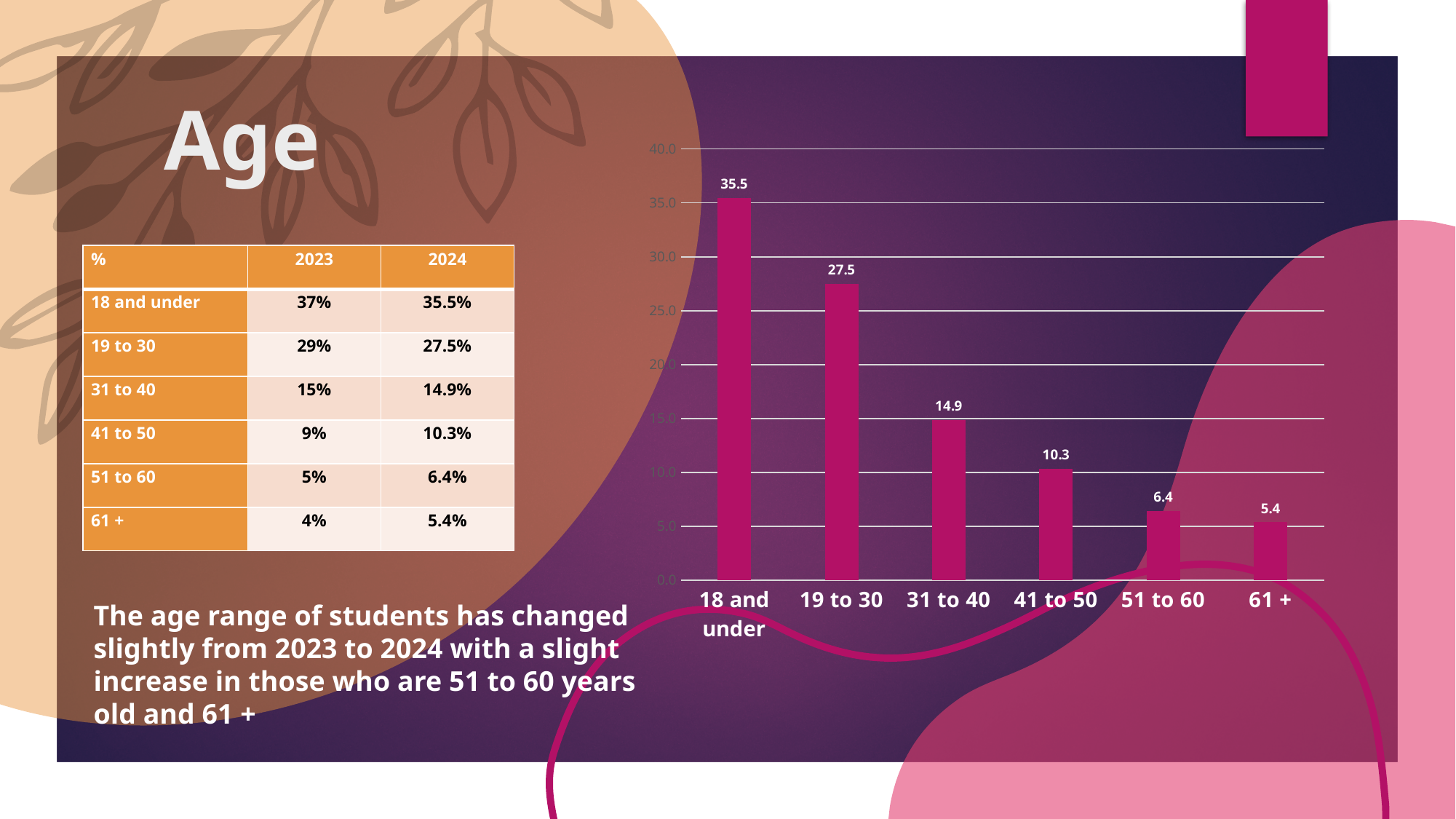
What kind of chart is shown on the slide? bar chart Is the value for 19 to 30 in the bar chart greater or less than 25.0? greater Which category has the highest value in the bar chart? 18 and under What is the value for the 61 + category in the bar chart? 5.4 Which is larger in the bar chart, the value for 51 to 60 or the value for 61 +? 51 to 60 What is the value for the 18 and under category in the bar chart? 35.5 Do the values in the bar chart rise or fall from left to right along the x axis? fall What is the difference between the values for 18 and under and 19 to 30 in the bar chart? 8.0 How many categories are shown in the bar chart? 6 What is the difference between the values for 31 to 40 and 41 to 50 in the bar chart? 4.6 Which category has the lowest value in the bar chart? 61 + What is the value for the 41 to 50 category in the bar chart? 10.3